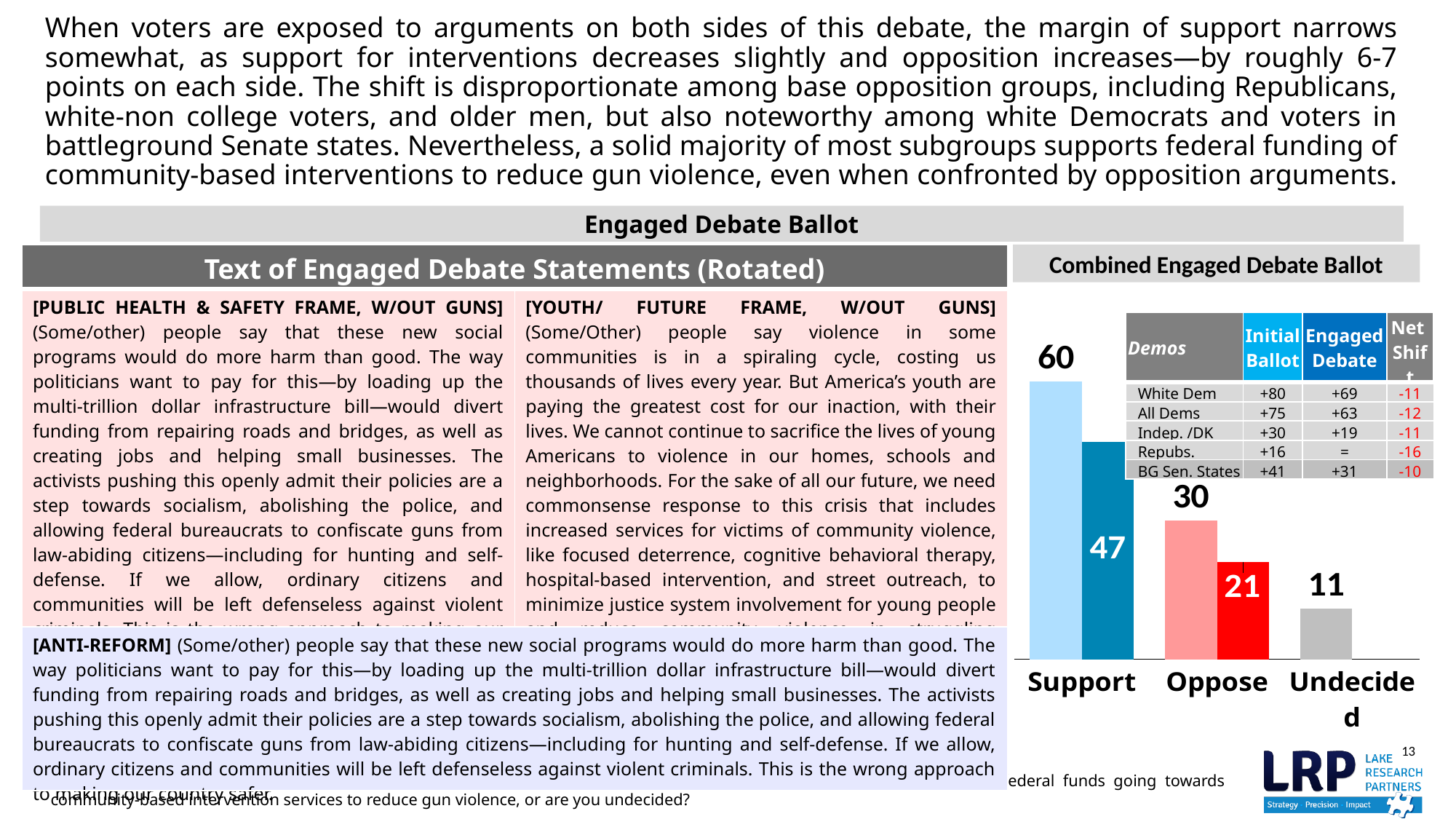
In the Combined Engaged Debate Ballot chart, which is larger: the dark blue Support bar or the bright red Oppose bar? The dark blue Support bar How many categories are shown on the x axis of the Combined Engaged Debate Ballot chart? 3 What type of chart is the Combined Engaged Debate Ballot? Bar chart In the Combined Engaged Debate Ballot chart, what value is shown on the dark blue bar for Support? 47 In the Combined Engaged Debate Ballot chart, what is the difference between the two Support bars (60 and 47)? 13 In the Combined Engaged Debate Ballot chart, what value is shown on the light red bar for Oppose? 30 In the Combined Engaged Debate Ballot chart, what is the difference between the light blue Support bar (60) and the light red Oppose bar (30)? 30 In the Combined Engaged Debate Ballot chart, what value is shown on the bright red bar for Oppose? 21 In the Combined Engaged Debate Ballot chart, what value is shown on the light blue bar for Support? 60 In the Combined Engaged Debate Ballot chart, which category has the lowest value? Undecided In the Combined Engaged Debate Ballot chart, which category has the highest bar? Support In the Combined Engaged Debate Ballot chart, what is the value for Undecided? 11